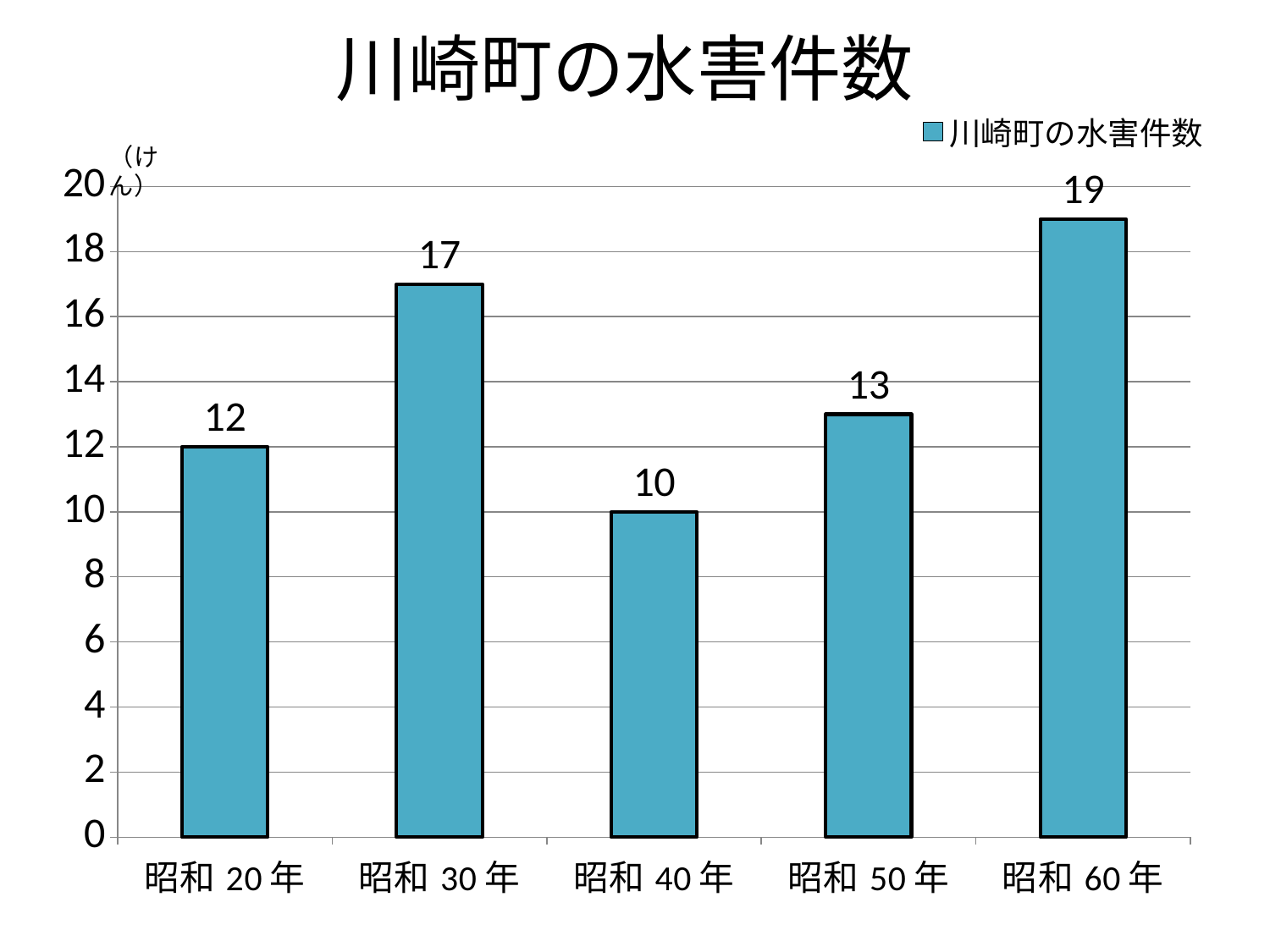
Which category has the highest value? 昭和 60年 How many categories are shown on the x axis? 5 What is the value for 昭和 60年? 19 What is the value for 昭和 40年? 10 Which is larger, the value for 昭和 20年 or the value for 昭和 50年? 昭和 50年 What is the value for 昭和 20年? 12 What is the title of the chart? 川崎町の水害件数 How many series does the legend list? 1 What is the difference between the values for 昭和 30年 and 昭和 50年? 4 What kind of chart is shown on the slide? bar chart Is the value for 昭和 30年 greater or less than 16? greater Which category has the lowest value? 昭和 40年